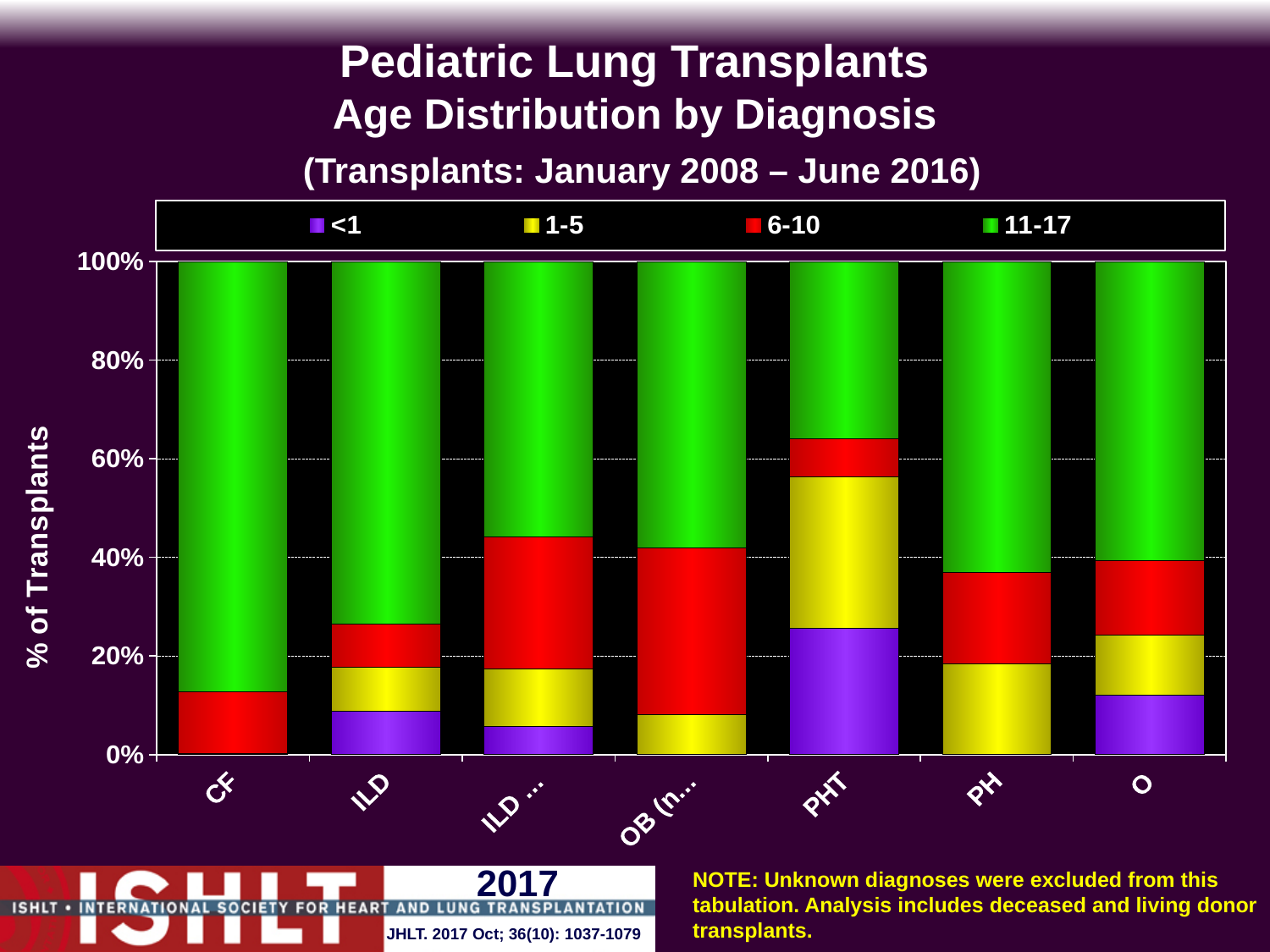
Which diagnosis has the smallest share of transplants in the 11-17 age group? PHT Is the share of transplants in the 11-17 age group for CF greater or less than 80%? greater What kind of chart is shown on the slide? Stacked bar chart Is the share of transplants in the 11-17 age group larger for CF or for PHT? CF What are the four age groups listed in the legend? <1, 1-5, 6-10, 11-17 Is the share of transplants in the 11-17 age group for PHT greater or less than 60%? less How many diagnosis categories are shown along the x axis? 7 Which diagnosis has the largest share of transplants in the <1 age group? PHT Is the share of transplants in the <1 age group for PHT greater or less than 20%? greater What is the label on the y axis? % of Transplants Which diagnosis has the largest share of transplants in the 11-17 age group? CF How many age groups does the legend list? 4